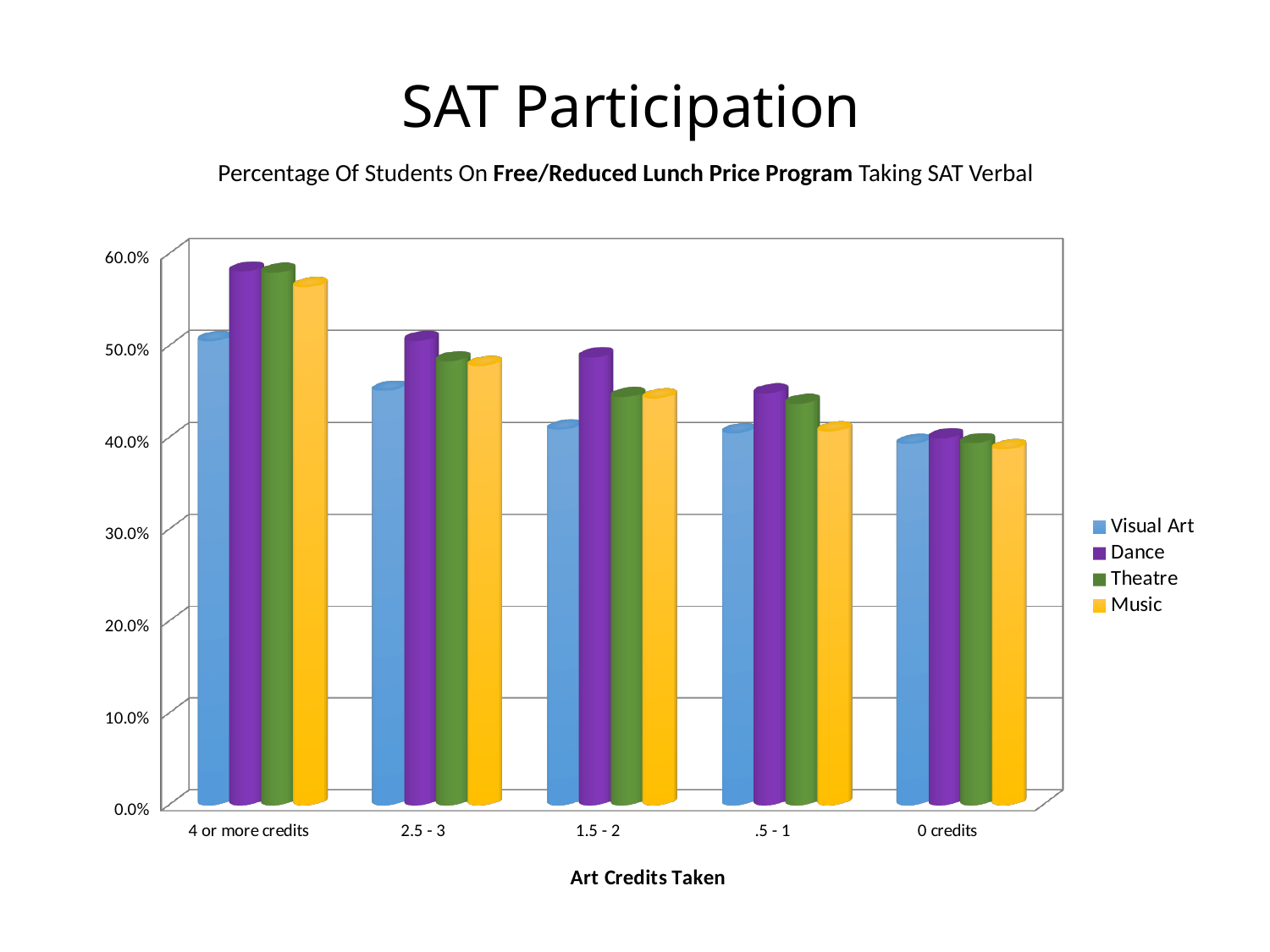
In the '2.5 - 3' credits category, which is larger: the Dance value or the Visual Art value? Dance Do the Visual Art values rise or fall moving from '4 or more credits' to '0 credits' along the x axis? fall Is the Music value for '0 credits' greater or less than 50.0%? less How many series does the legend list? 4 Is the Dance value for '4 or more credits' greater or less than 50.0%? greater Which series has the highest value in the '1.5 - 2' credits category? Dance Which series has the lowest value in the '4 or more credits' category? Visual Art Is the Visual Art value for '1.5 - 2' credits greater or less than 50.0%? less What kind of chart is shown on the slide? bar chart How many art-credit categories are shown on the x axis? 5 What is the title of the x axis? Art Credits Taken